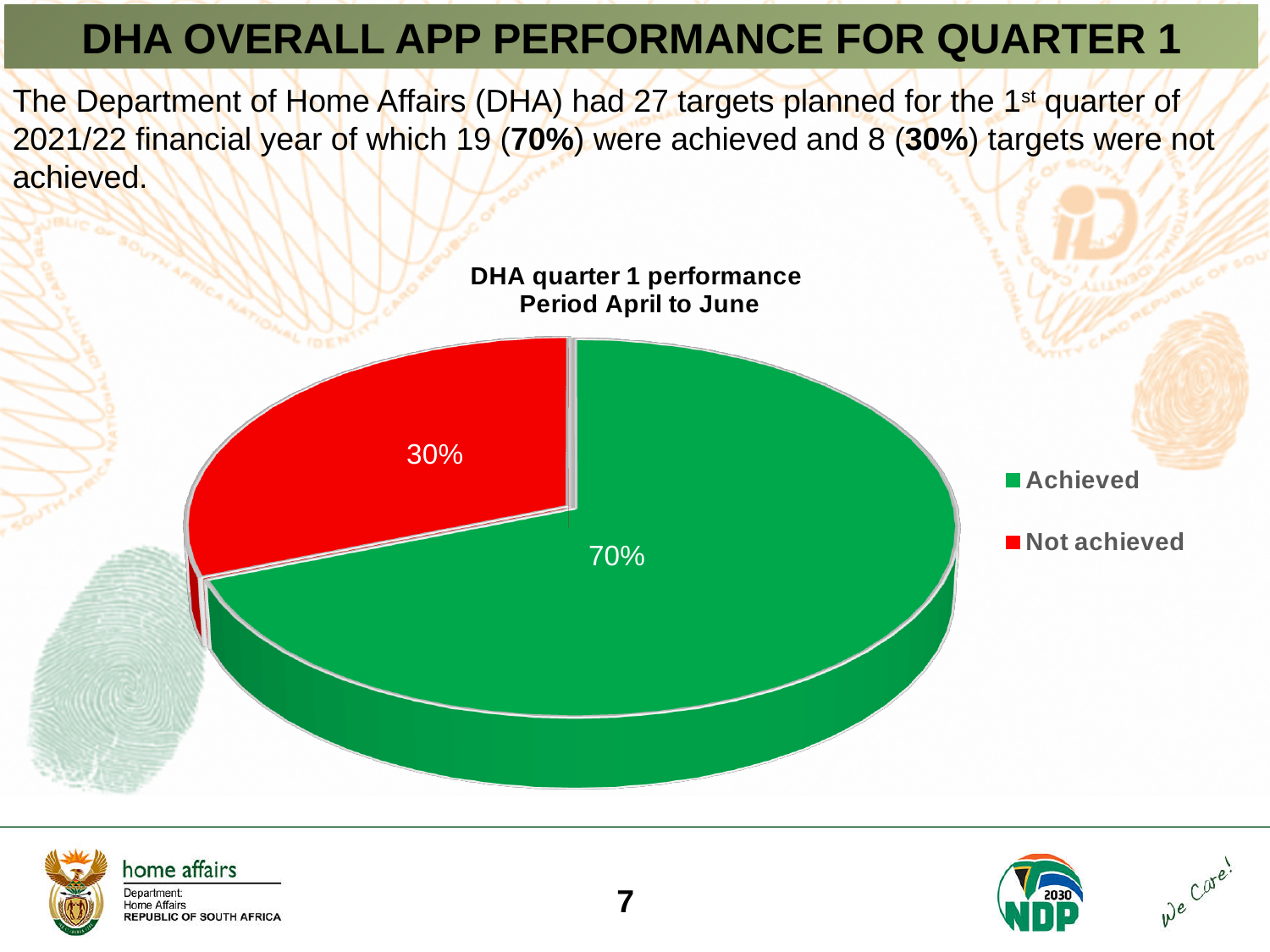
What share of the pie does the Not achieved slice represent? 30% What is the difference between the Achieved and Not achieved shares? 40% Which category has the largest share of the pie? Achieved What colour is the Not achieved slice? red What kind of chart is shown on the slide? pie chart Which is larger, the Achieved share or the Not achieved share? Achieved What is the value for Achieved in the pie chart? 70% How many slices does the pie chart have? 2 How many entries does the legend list? 2 What is the title of the chart? DHA quarter 1 performance Period April to June What is the value for Not achieved in the pie chart? 30% Which category has the smallest share of the pie? Not achieved